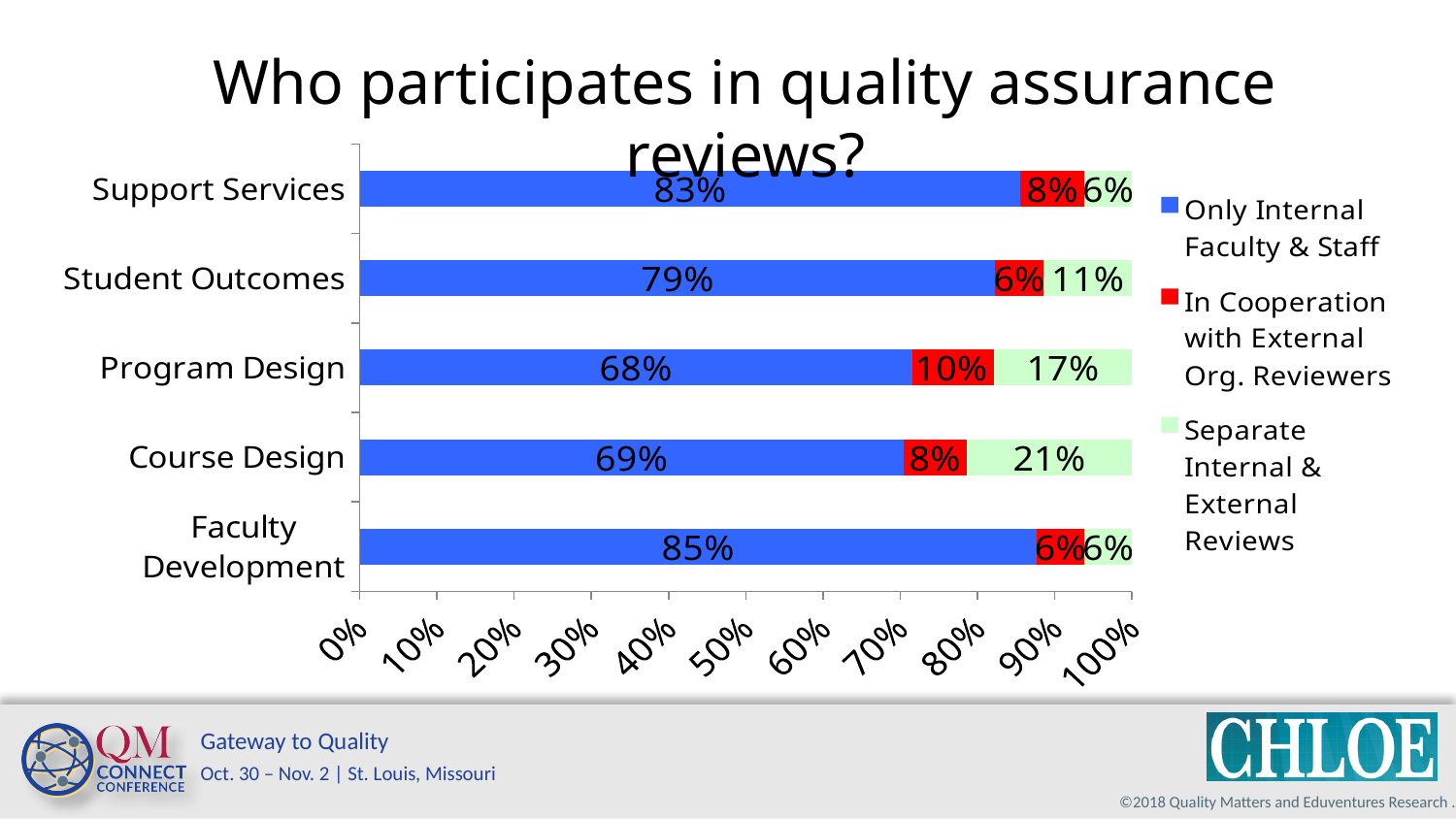
Which category has the highest value for Only Internal Faculty & Staff? Faculty Development What is the value for Separate Internal & External Reviews for Course Design? 21% Which category has the highest value for Separate Internal & External Reviews? Course Design What is the difference between the Only Internal Faculty & Staff values for Faculty Development and Program Design? 17% How many series does the legend list? 3 What colour represents In Cooperation with External Org. Reviewers? Red How many categories are shown on the chart? 5 What percentage of Support Services reviews are done by Only Internal Faculty & Staff? 83% What is the value for In Cooperation with External Org. Reviewers for Program Design? 10% Which is larger: the Separate Internal & External Reviews value for Program Design or for Student Outcomes? Program Design What kind of chart is shown on the slide? Stacked bar chart Which category has the lowest value for Only Internal Faculty & Staff? Program Design